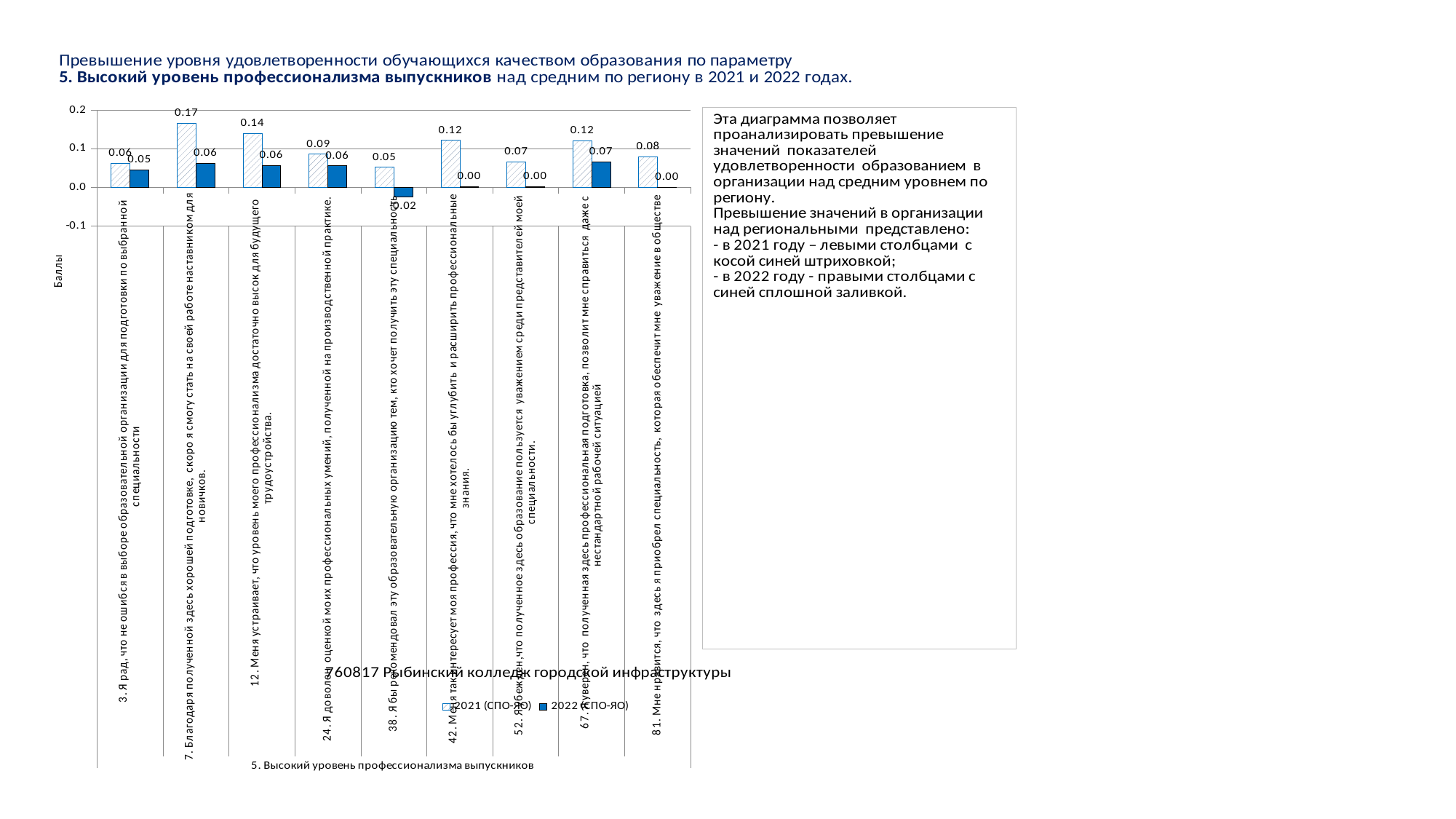
What is the difference between the 2021 and 2022 values for statement 7? 0.11 What is the 2022 (СПО-ЯО) value for statement 42 (Меня так интересует моя профессия...)? 0.00 What is the 2022 (СПО-ЯО) value for statement 38 (Я бы рекомендовал эту образовательную организацию...)? -0.02 Which statement has the lowest 2022 (СПО-ЯО) value? 38. Я бы рекомендовал эту образовательную организацию тем, кто хочет получить эту специальность. What is the 2022 (СПО-ЯО) value for statement 67 (Я уверен, что полученная здесь профессиональная подготовка...)? 0.07 Which statement has the highest 2021 (СПО-ЯО) value? 7. Благодаря полученной здесь хорошей подготовке, скоро я смогу стать на своей работе наставником для новичков. How many series does the legend list? 2 What is the label of the vertical axis? Баллы What is the 2021 (СПО-ЯО) value for statement 7 (Благодаря полученной здесь хорошей подготовке...)? 0.17 What type of chart is shown on the slide? bar chart Which is larger for statement 12: the 2021 (СПО-ЯО) value or the 2022 (СПО-ЯО) value? 2021 (СПО-ЯО) How many statement categories are plotted on the x axis? 9